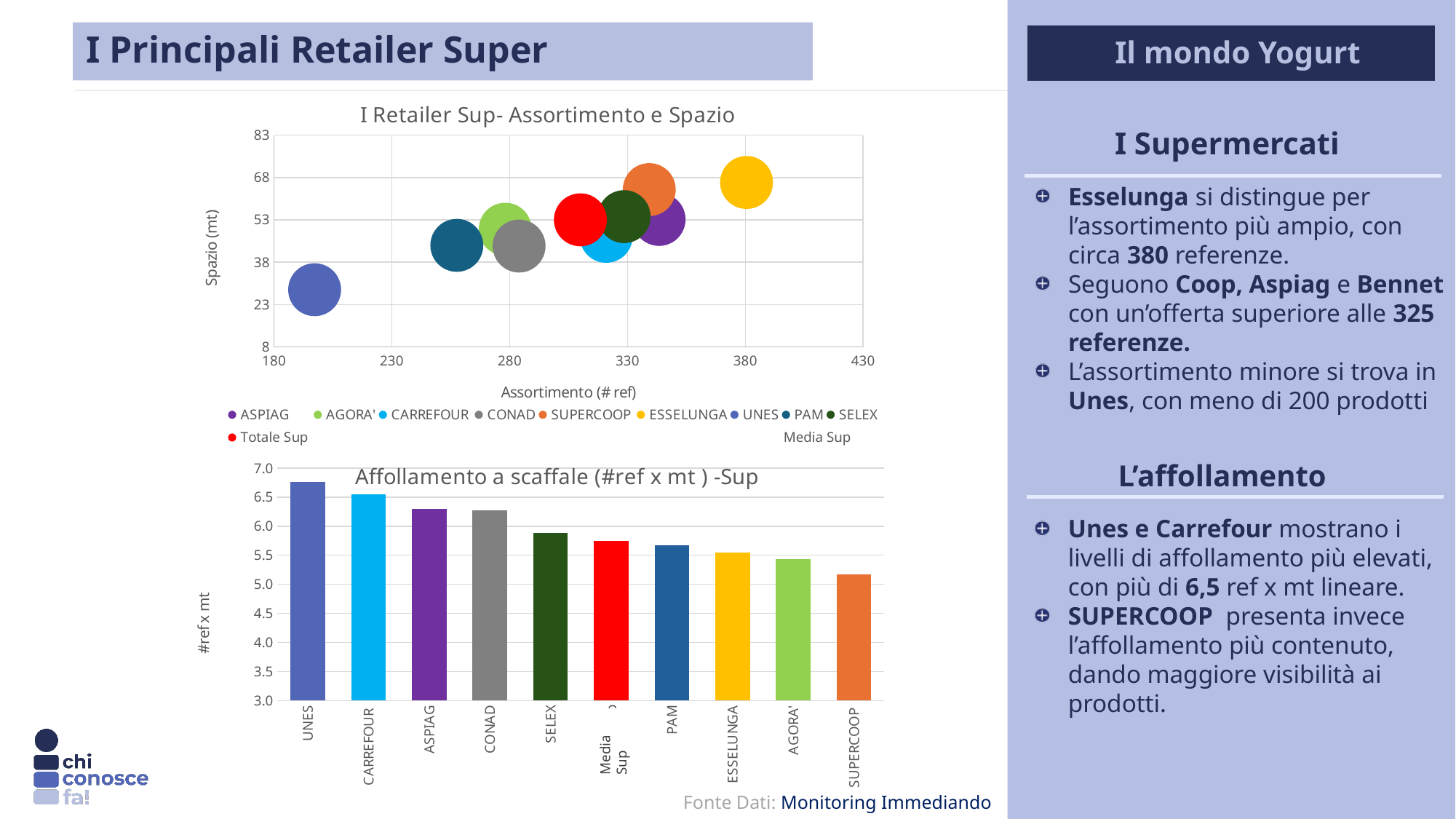
What kind of chart is the bottom chart, "Affollamento a scaffale (#ref x mt ) -Sup"? bar chart In the bottom chart "Affollamento a scaffale", do the bar values rise or fall from left to right? fall In the bottom chart "Affollamento a scaffale", which is larger, the value for SELEX or the value for PAM? SELEX How many bars are shown in the bottom chart "Affollamento a scaffale"? 10 What is the label of the x axis in the top chart "I Retailer Sup- Assortimento e Spazio"? Assortimento (# ref) In the bottom chart "Affollamento a scaffale", is the value for SELEX greater or less than 5.5? greater In the bottom chart "Affollamento a scaffale", is the value for UNES greater or less than 6.5? greater In the top chart "I Retailer Sup- Assortimento e Spazio", which retailer has the highest Assortimento (# ref)? ESSELUNGA In the top chart "I Retailer Sup- Assortimento e Spazio", is the Assortimento value for UNES greater or less than 230? less In the bottom chart "Affollamento a scaffale", which retailer has the lowest value? SUPERCOOP In the bottom chart "Affollamento a scaffale", which retailer has the highest value? UNES